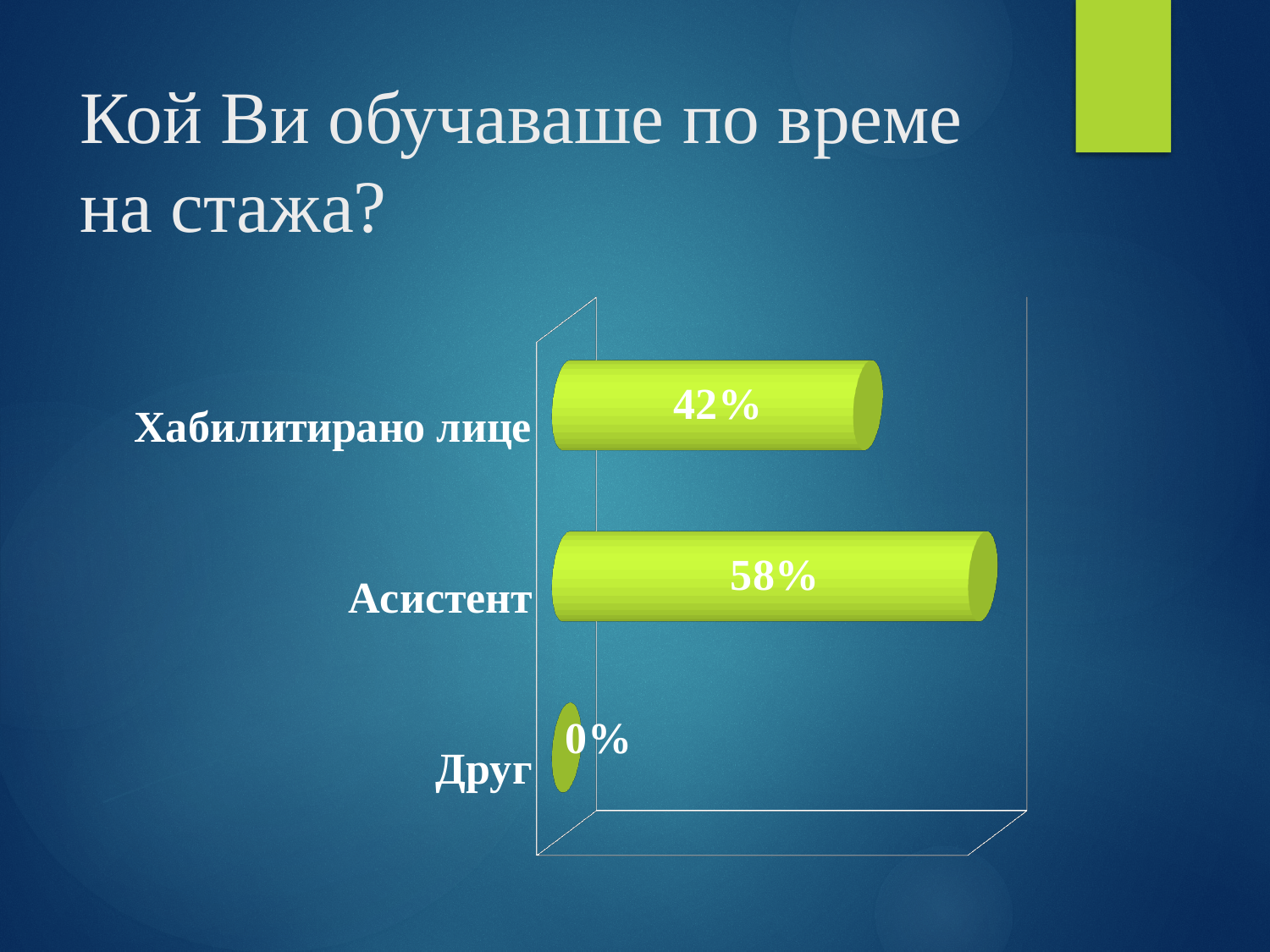
What is the total of the values for Хабилитирано лице and Асистент? 100% Which category has the lowest value? Друг What is the value for Друг? 0% Which category has the highest value? Асистент What colour are the bars in the chart? green What is the value for Хабилитирано лице? 42% Which is larger, the value for Хабилитирано лице or the value for Асистент? Асистент What is the value for Асистент? 58% What is the difference between the values for Асистент and Хабилитирано лице? 16% How many categories are shown in the chart? 3 What kind of chart is shown on the slide? bar chart What is the title of the slide containing the chart? Кой Ви обучаваше по време на стажа?